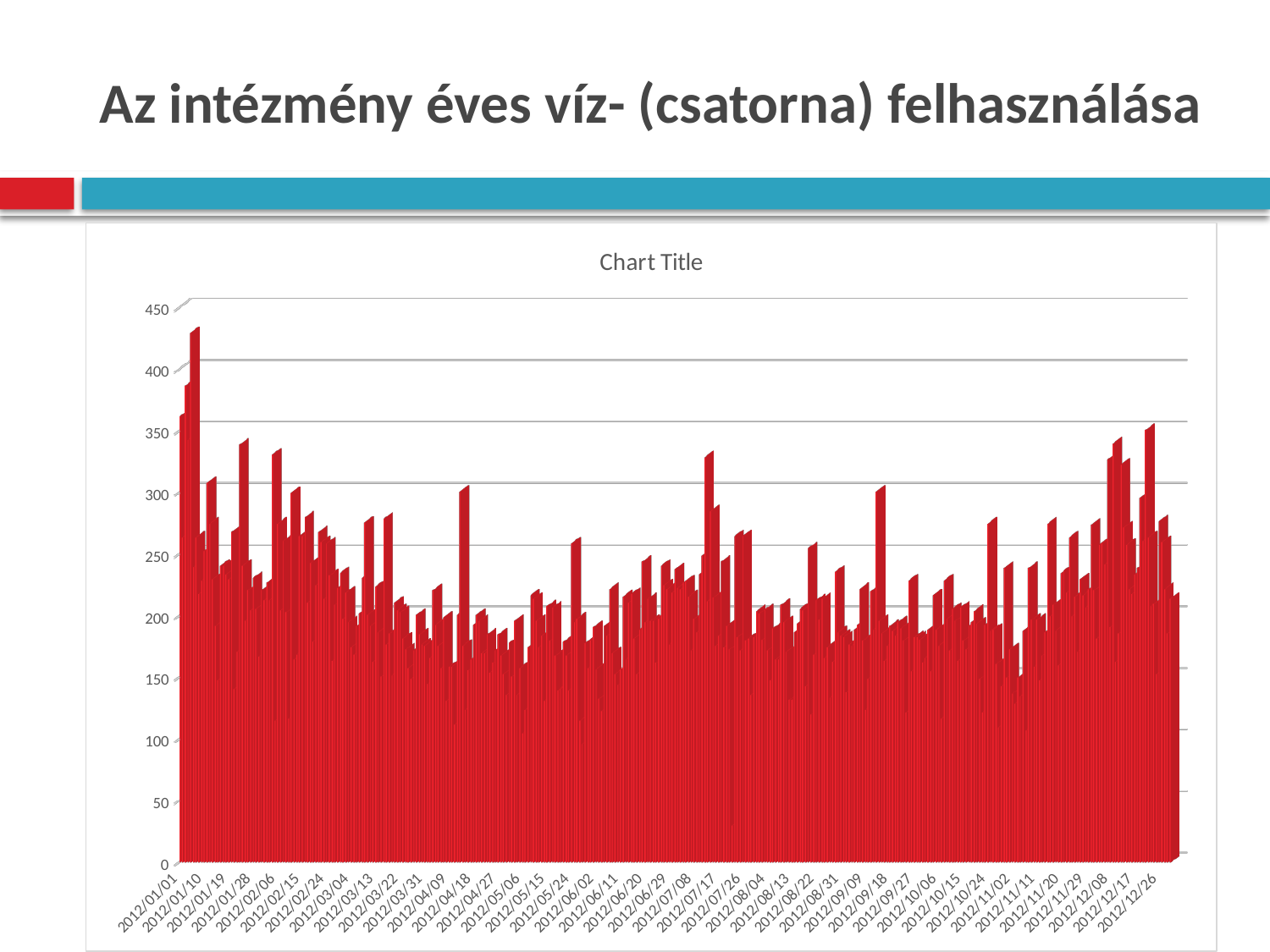
What is the last date label on the horizontal axis? 2012/12/26 Is the tallest bar in the chart greater or less than 400? greater What is the title printed above the chart? Chart Title Does any bar in the chart exceed 450? No What is the highest value labelled on the vertical axis? 450 Is the value for 2012/01/01 greater or less than 300? greater Around which month does the tallest bar of the year occur? January What kind of chart is shown on the slide? bar chart What is the first date label on the horizontal axis? 2012/01/01 What colour are the bars in the chart? red